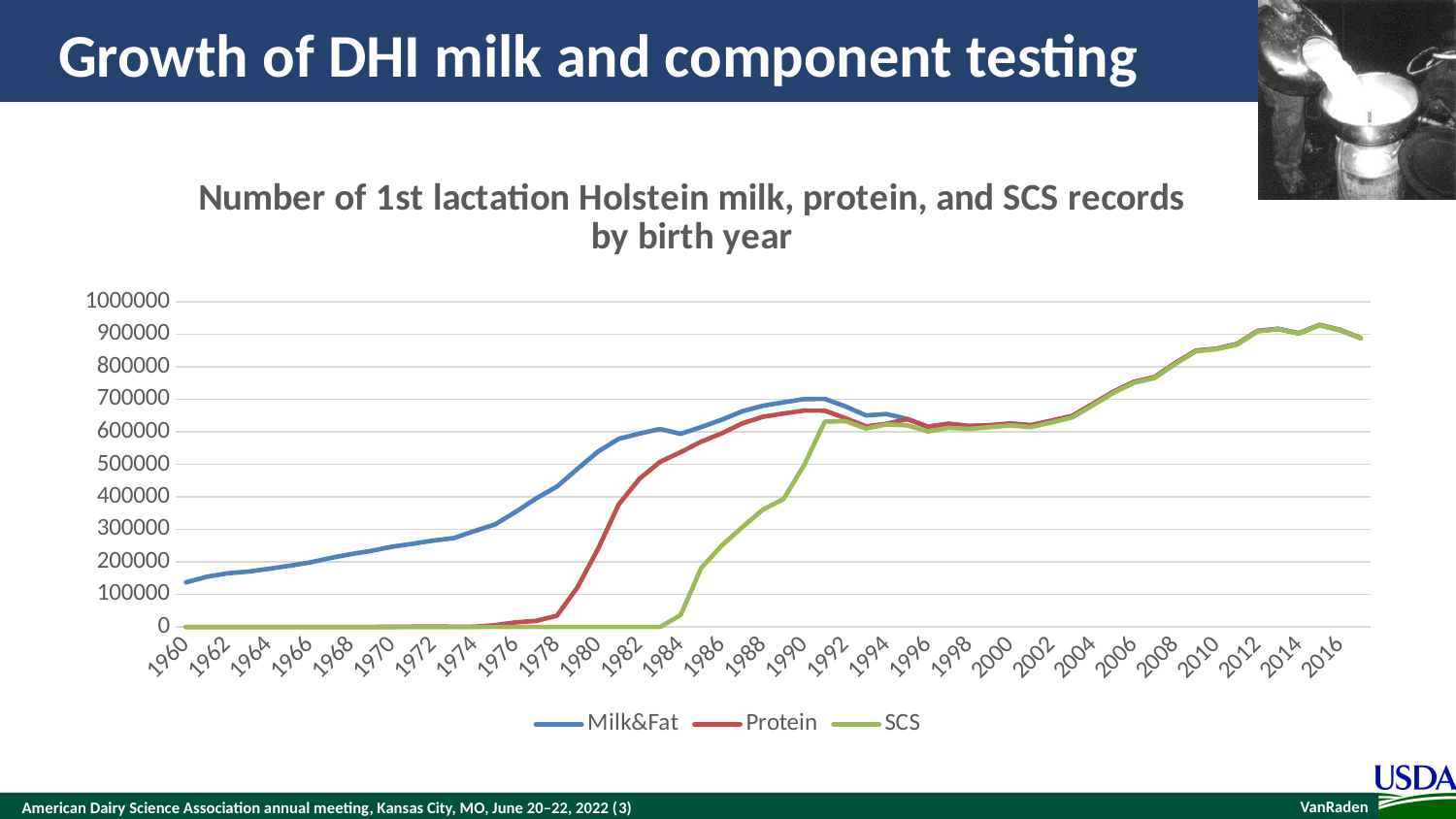
Which series has the lowest value in 1980? SCS Is the SCS value for 1980 greater or less than 100000? less Is the SCS value for 2008 greater or less than 700000? greater Does the Milk&Fat series rise or fall from 1960 to 1990? rise What is the title of the chart? Number of 1st lactation Holstein milk, protein, and SCS records by birth year How many series does the legend list? 3 What kind of chart is shown on the slide? line chart Is the Protein value for 1970 greater or less than 100000? less Which series has the highest value in 1980? Milk&Fat What are the three series named in the legend? Milk&Fat, Protein, SCS